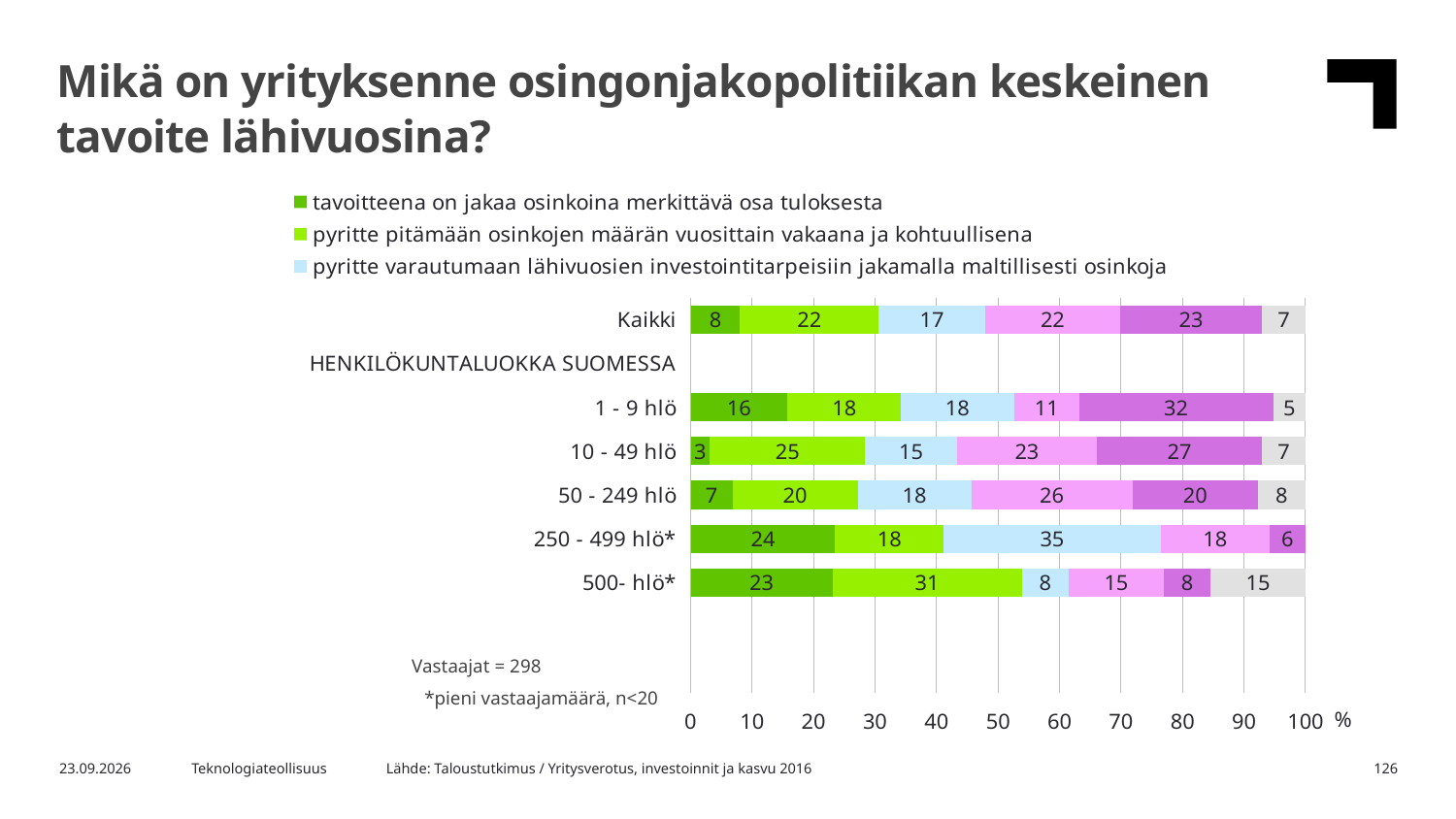
How many categories have bars plotted in the chart? 6 Which has the larger 'pyritte varautumaan lähivuosien investointitarpeisiin jakamalla maltillisesti osinkoja' value: '50 - 249 hlö' or '10 - 49 hlö'? 50 - 249 hlö How many respondents (Vastaajat) does the slide report? 298 How many series does the legend list? 3 What is the total of the labelled segments in the '500- hlö*' bar? 100 Which category has the highest value for 'tavoitteena on jakaa osinkoina merkittävä osa tuloksesta'? 250 - 499 hlö* How much larger is the 'pyritte pitämään osinkojen määrän vuosittain vakaana ja kohtuullisena' value for '500- hlö*' than for 'Kaikki'? 9 What is the value of the 'pyritte pitämään osinkojen määrän vuosittain vakaana ja kohtuullisena' segment for '1 - 9 hlö'? 18 What is the value of the 'tavoitteena on jakaa osinkoina merkittävä osa tuloksesta' segment for the 'Kaikki' bar? 8 What is the value of the 'pyritte varautumaan lähivuosien investointitarpeisiin jakamalla maltillisesti osinkoja' segment for '250 - 499 hlö*'? 35 Which category has the lowest value for 'tavoitteena on jakaa osinkoina merkittävä osa tuloksesta'? 10 - 49 hlö What kind of chart is shown on the slide? Stacked bar chart